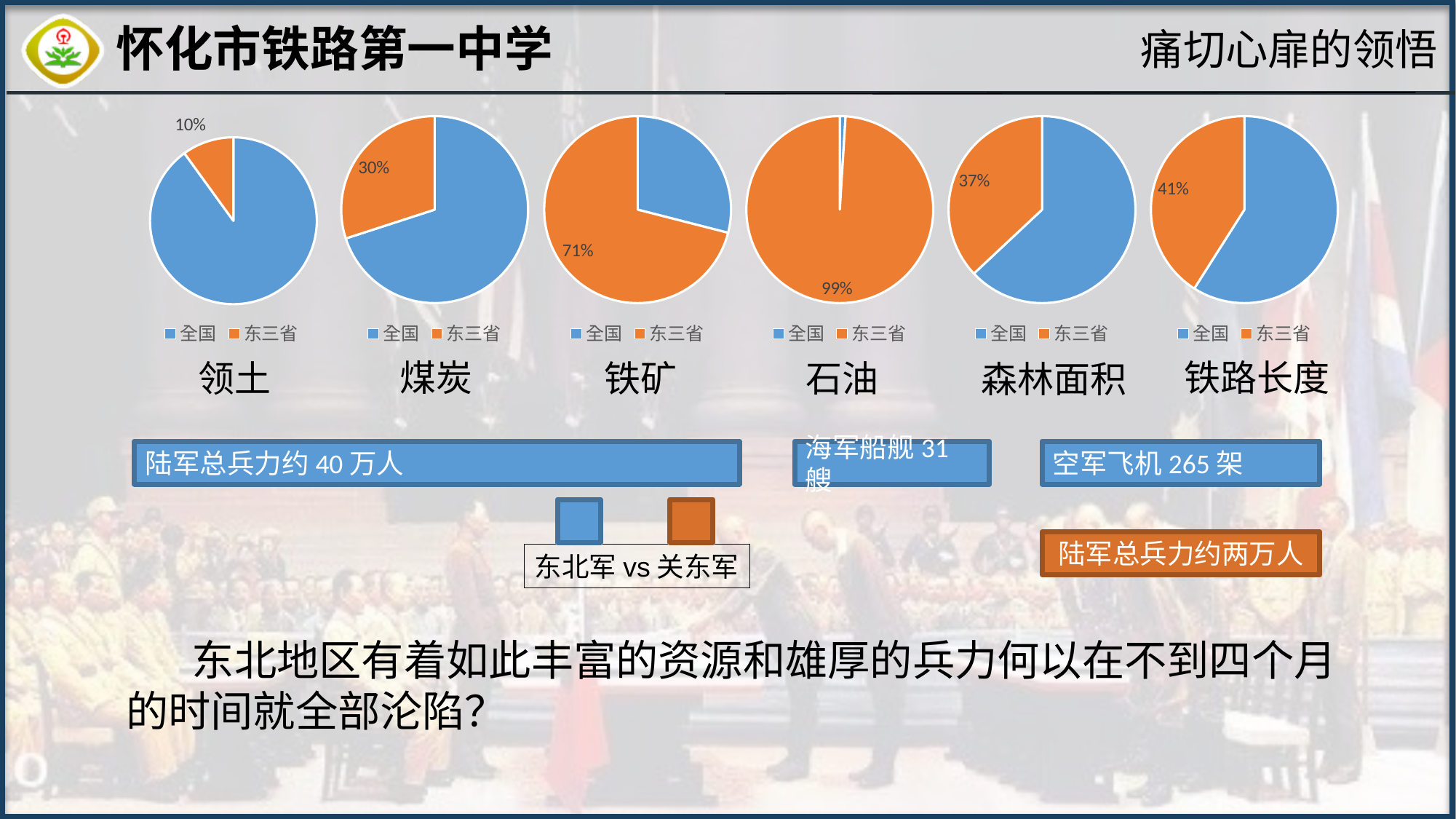
In the 领土 pie chart, what percentage is shown for the 东三省 slice? 10% In the 石油 pie chart, what percentage is shown for the 东三省 slice? 99% How many entries does the legend of the 石油 pie chart list? 2 Which is larger: the 东三省 share in the 铁路长度 chart or in the 森林面积 chart? 铁路长度 In the 煤炭 pie chart, what percentage is shown for the 东三省 slice? 30% In the 森林面积 pie chart, what percentage is shown for the 东三省 slice? 37% What type of chart is used for 领土, 煤炭, 铁矿, 石油, 森林面积 and 铁路长度? Pie chart Across the six pie charts, which one shows the largest 东三省 share? 石油 What is the difference between the 东三省 share in the 铁矿 chart and the 东三省 share in the 煤炭 chart? 41% Across the six pie charts, which one shows the smallest 东三省 share? 领土 In the 铁路长度 pie chart, what percentage is shown for the 东三省 slice? 41% In the 铁矿 pie chart, what percentage is shown for the 东三省 slice? 71%